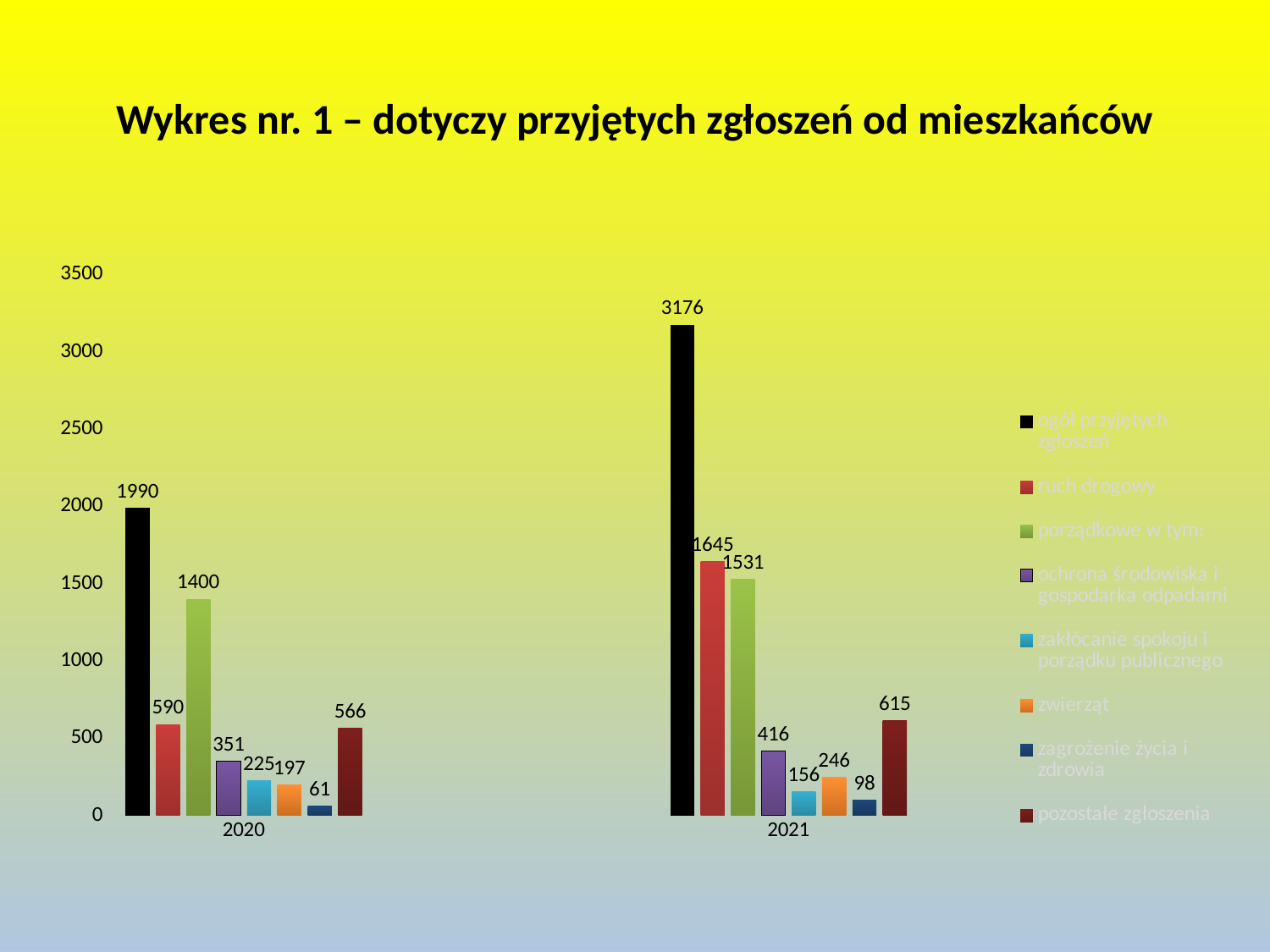
Which is larger: 'ruch drogowy' in 2021 or 'porządkowe w tym:' in 2021? ruch drogowy in 2021 What is the title of the chart? Wykres nr. 1 – dotyczy przyjętych zgłoszeń od mieszkańców How many series does the legend list? 8 What is the difference between the 'ogół przyjętych zgłoszeń' values for 2021 and 2020? 1186 How many year categories are shown on the x axis? 2 What kind of chart is shown on the slide? bar chart What is the value for 'ogół przyjętych zgłoszeń' in 2021? 3176 What is the value for 'ruch drogowy' in 2020? 590 Which series has the highest value in 2020? ogół przyjętych zgłoszeń What is the value for 'pozostałe zgłoszenia' in 2021? 615 Which series has the lowest value in 2021? zagrożenie życia i zdrowia What is the value for 'zagrożenie życia i zdrowia' in 2020? 61